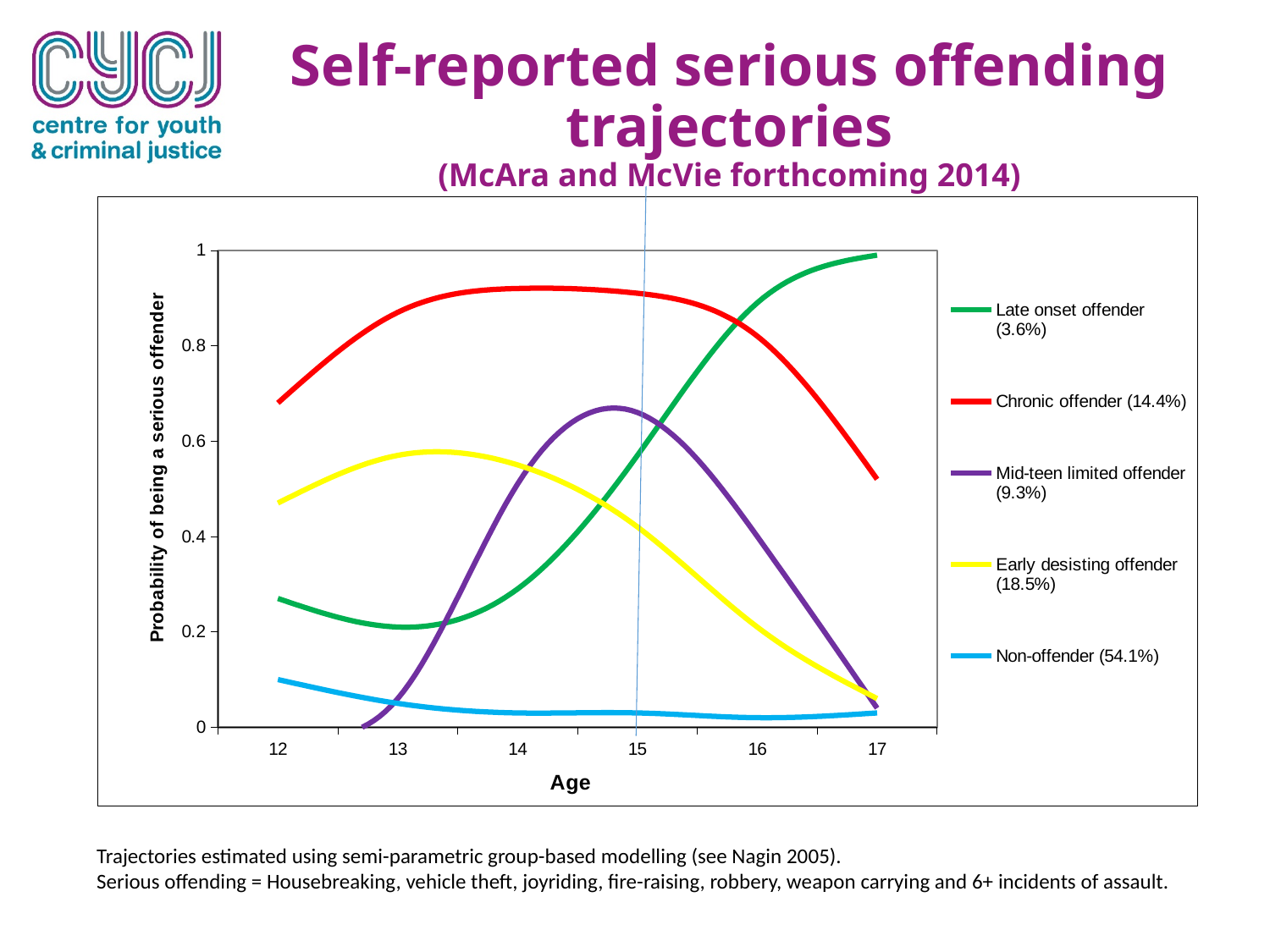
How many series does the legend list? 5 Does the Late onset offender line rise or fall between age 14 and age 17? rises What percentage is shown in the legend for Non-offender? 54.1% Does the Early desisting offender line rise or fall between age 14 and age 17? falls How many age values are marked on the x axis? 6 Which series has the highest probability at age 14? Chronic offender (14.4%) At age 13, which is larger: the value for Early desisting offender or the value for Late onset offender? Early desisting offender Is the value for Chronic offender at age 12 greater or less than 0.6? greater Is the value for Late onset offender at age 17 greater or less than 0.8? greater Is the value for Mid-teen limited offender at age 15 greater or less than 0.4? greater Which series has the lowest probability at age 14? Non-offender (54.1%) What kind of chart is shown on the slide? line chart